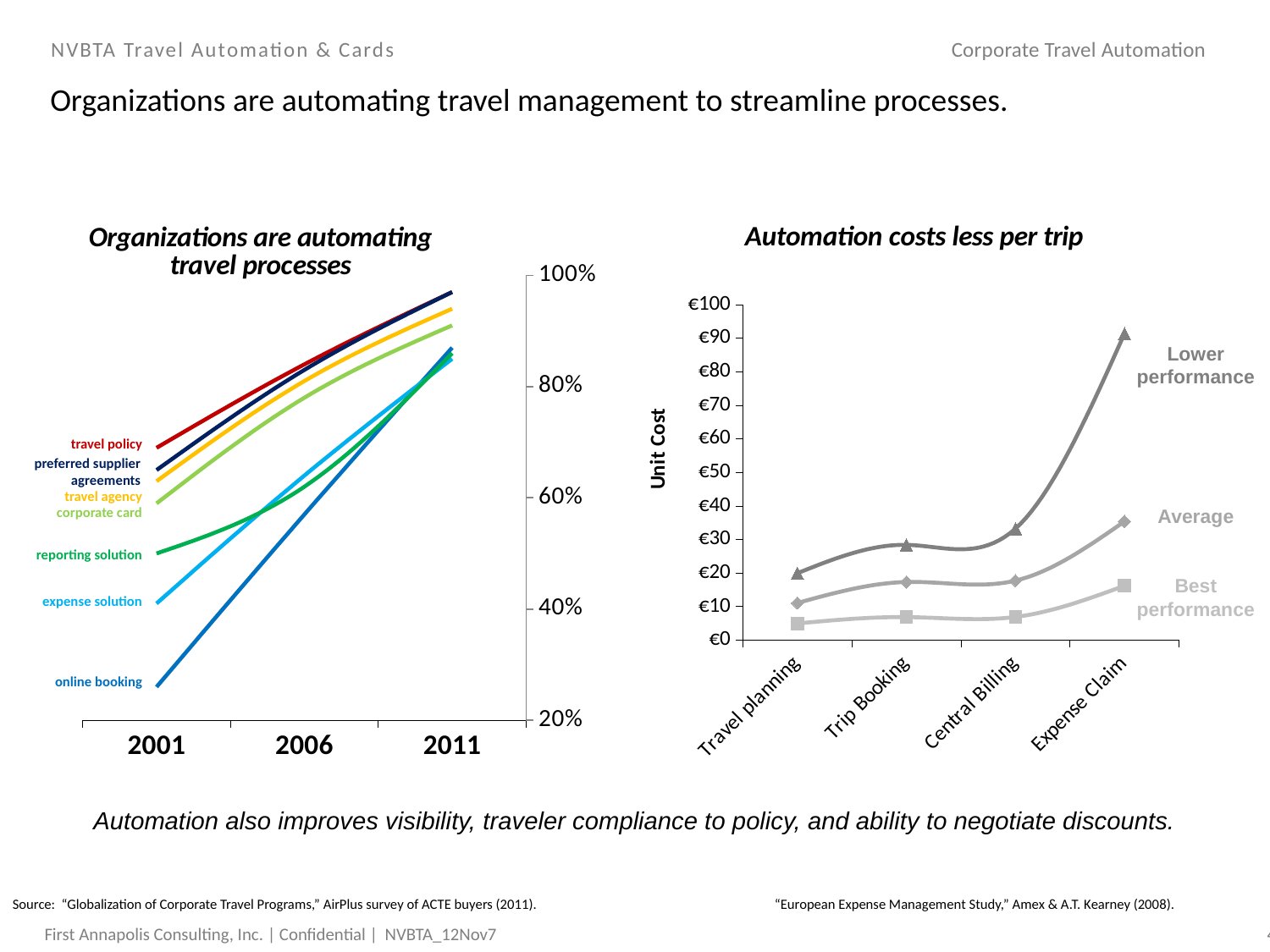
In the chart titled "Automation costs less per trip", how many categories are shown on the x axis? 4 In the chart titled "Automation costs less per trip", what is the label of the y axis? Unit Cost In the chart titled "Automation costs less per trip", how many series are plotted? 3 In the chart titled "Organizations are automating travel processes", which years are shown on the x axis? 2001, 2006, 2011 In the chart titled "Organizations are automating travel processes", do the values for online booking rise or fall from 2001 to 2011? rise In the chart titled "Organizations are automating travel processes", which series has the lowest value in 2001? online booking In the chart titled "Organizations are automating travel processes", how many series are plotted? 7 In the chart titled "Organizations are automating travel processes", which series has the highest value in 2001? travel policy In the chart titled "Automation costs less per trip", is the Lower performance value for Expense Claim greater or less than €80? greater In the chart titled "Organizations are automating travel processes", is the value for online booking in 2001 greater or less than 40%? less In the chart titled "Organizations are automating travel processes", what kind of chart is shown? line chart In the chart titled "Automation costs less per trip", for which category is the Lower performance series highest? Expense Claim